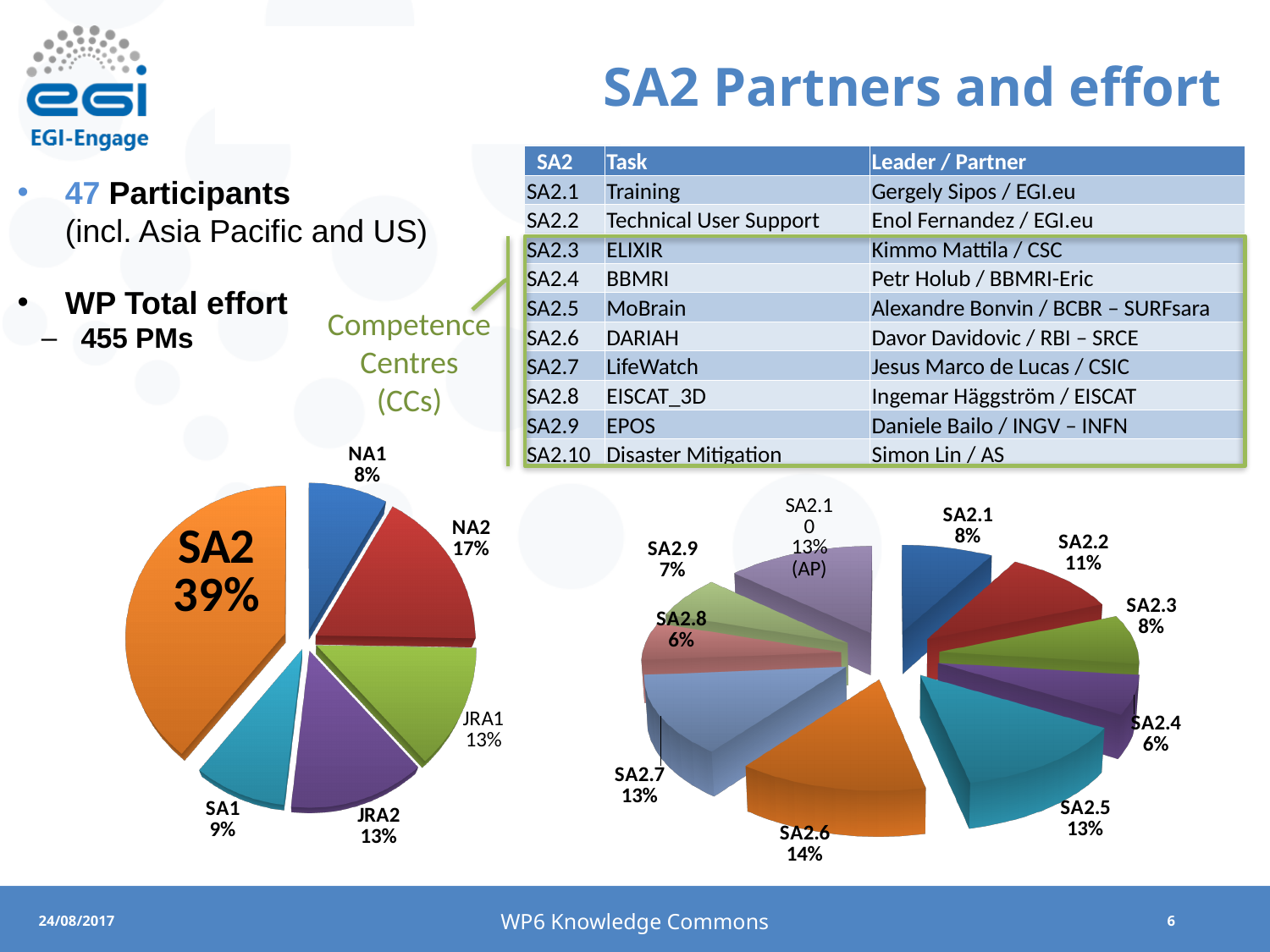
In the pie chart on the left of the slide, what share does SA2 have? 39% In the pie chart on the left of the slide, which is larger, SA1 or NA1? SA1 In the pie chart on the right of the slide, which slice is the largest? SA2.6 What kind of chart is shown on the right of the slide? Pie chart In the pie chart on the left of the slide, which slice is the largest? SA2 In the pie chart on the left of the slide, which slice is the smallest? NA1 In the pie chart on the right of the slide, what share does SA2.2 have? 11% In the pie chart on the right of the slide, what share does SA2.6 have? 14% In the pie chart on the left of the slide, how many slices are there? 6 In the pie chart on the left of the slide, what is the difference between the SA2 share and the NA2 share? 22% In the pie chart on the right of the slide, how many slices are there? 10 In the pie chart on the left of the slide, what share does NA2 have? 17%